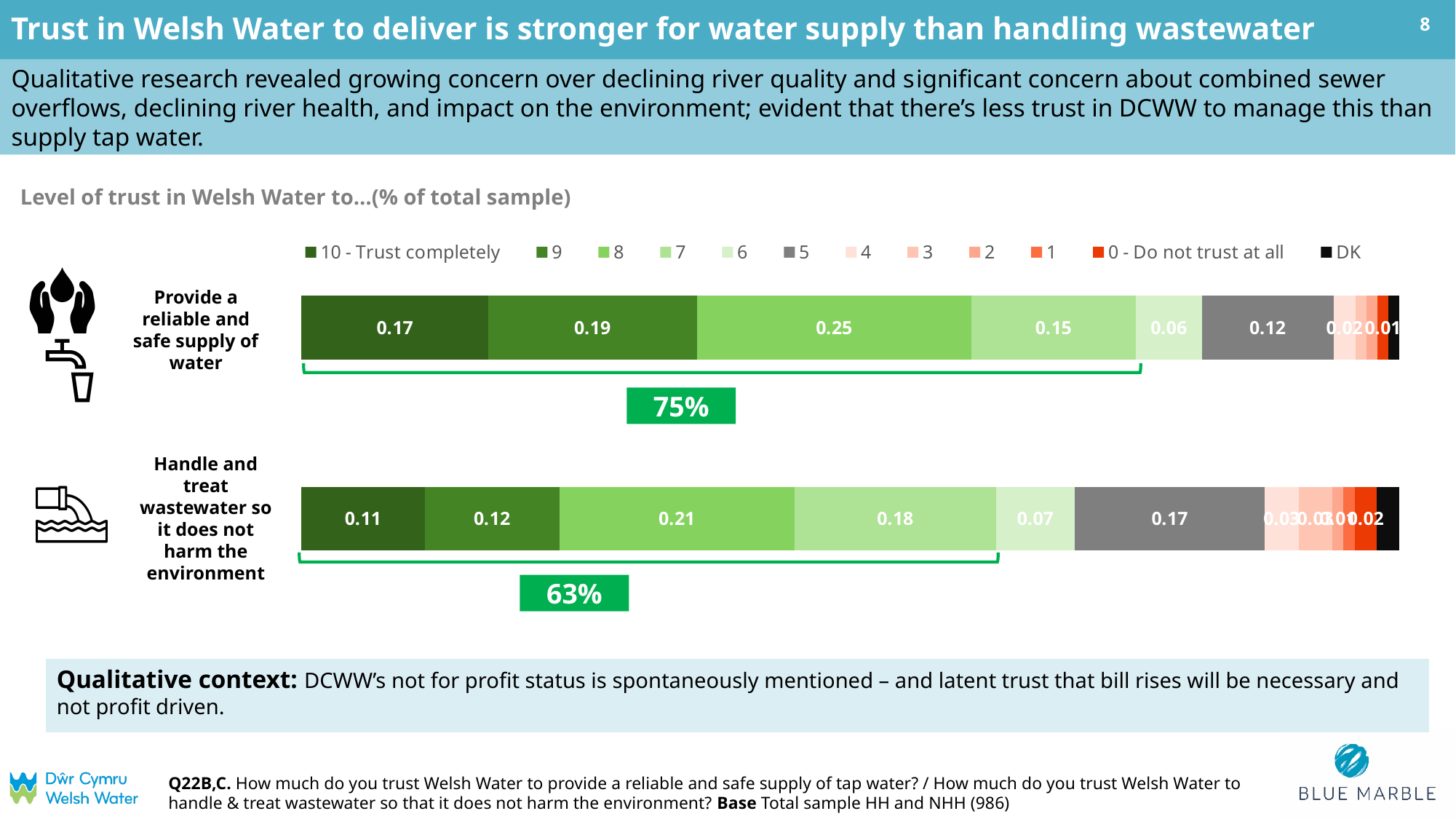
What is the value for '5' for 'Handle and treat wastewater so it does not harm the environment'? 0.17 How many series does the legend list? 12 What kind of chart is shown on the slide? Stacked bar chart What percentage is shown in the green bracket label beneath the 'Handle and treat wastewater so it does not harm the environment' bar? 63% Which category has the larger value for '9': 'Provide a reliable and safe supply of water' or 'Handle and treat wastewater so it does not harm the environment'? Provide a reliable and safe supply of water What is the difference between the '8' values for 'Provide a reliable and safe supply of water' (0.25) and 'Handle and treat wastewater so it does not harm the environment' (0.21)? 0.04 What is the title of the chart? Level of trust in Welsh Water to…(% of total sample) What is the value for '8' for 'Handle and treat wastewater so it does not harm the environment'? 0.21 What is the value for '10 - Trust completely' for 'Provide a reliable and safe supply of water'? 0.17 What is the value for '7' for 'Provide a reliable and safe supply of water'? 0.15 Which series has the largest value within the 'Provide a reliable and safe supply of water' bar? 8 How many categories (bars) are plotted in the chart? 2